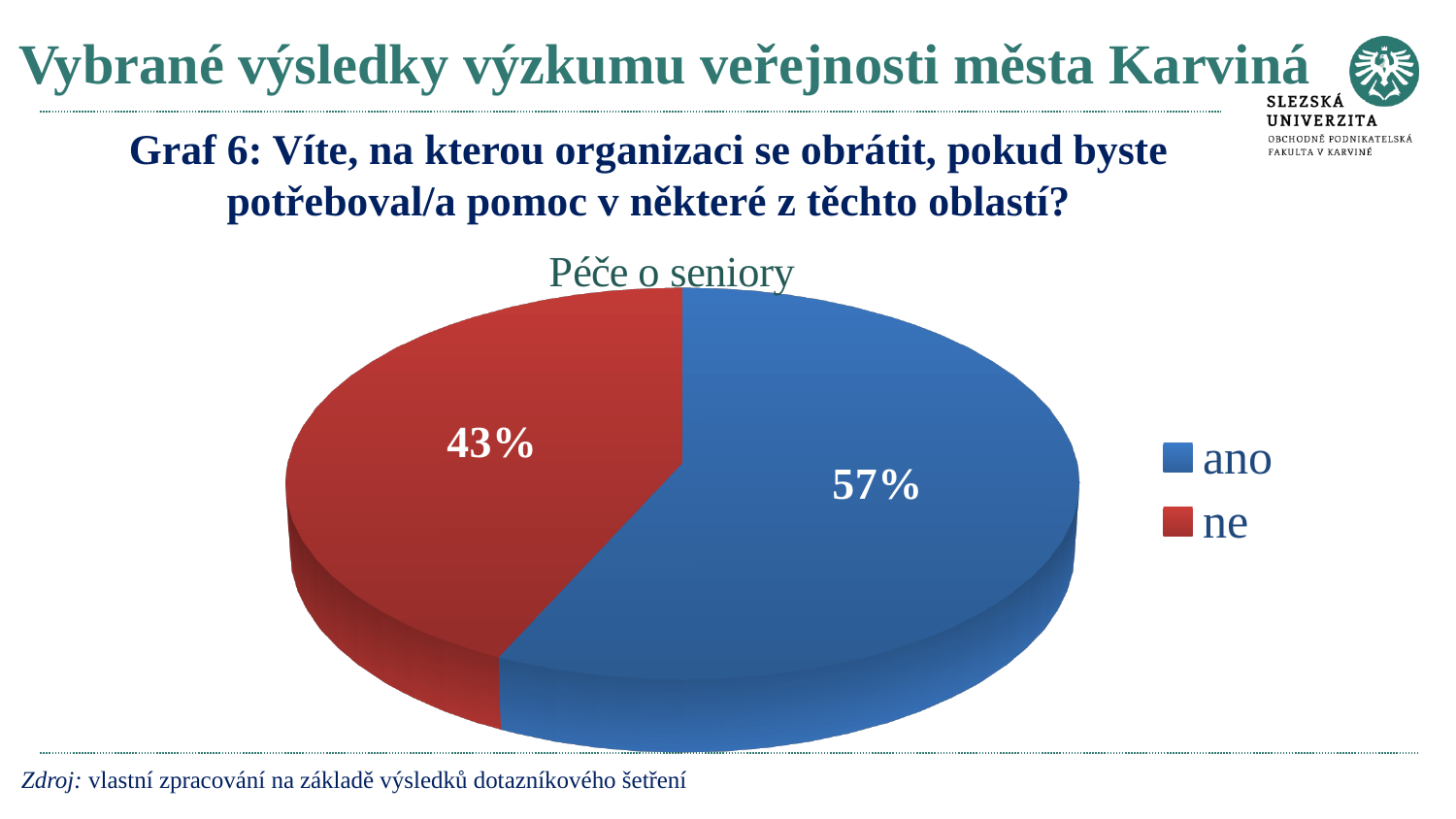
What kind of chart is shown on the slide? pie chart What is the chart's title? Péče o seniory How many slices does the pie chart have? 2 What colour is the "ne" slice? red Which is larger, the "ano" slice or the "ne" slice? ano Which slice is the largest? ano What is the difference in percentage points between the "ano" and "ne" slices? 14 What share of the pie does "ne" represent? 43% What share of the pie does "ano" represent? 57% How many entries does the legend list? 2 Is the share for "ano" greater or less than 50%? greater Which slice is the smallest? ne